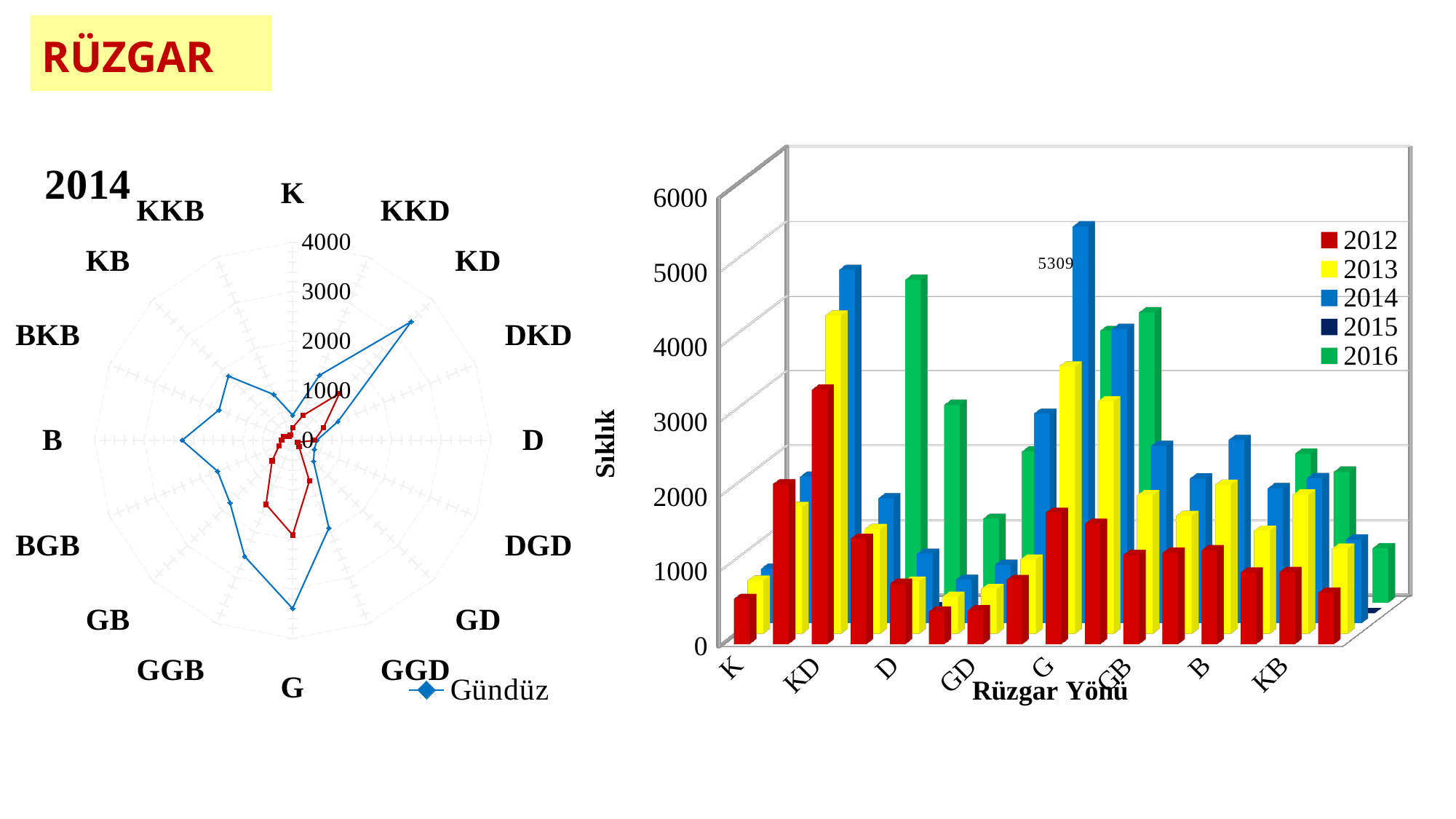
What is the title of the x axis of the right-hand chart? Rüzgar Yönü In the right-hand chart, is the 2012 value for KD greater or less than 2000? greater How many series does the legend of the right-hand chart list? 5 How many wind-direction categories are shown on the x axis of the right-hand chart? 8 What is the title of the radar chart on the left of the slide? 2014 What kind of chart is the chart on the right of the slide? bar chart How many direction categories does the radar chart on the left have? 16 In the right-hand chart, what value is printed on the 2014 bar for G? 5309 In the right-hand chart, is the 2016 value for D greater or less than 4000? less In the right-hand chart, which wind direction has the highest 2014 value? G In the right-hand chart, is the 2014 value for G larger or the 2014 value for KD? G